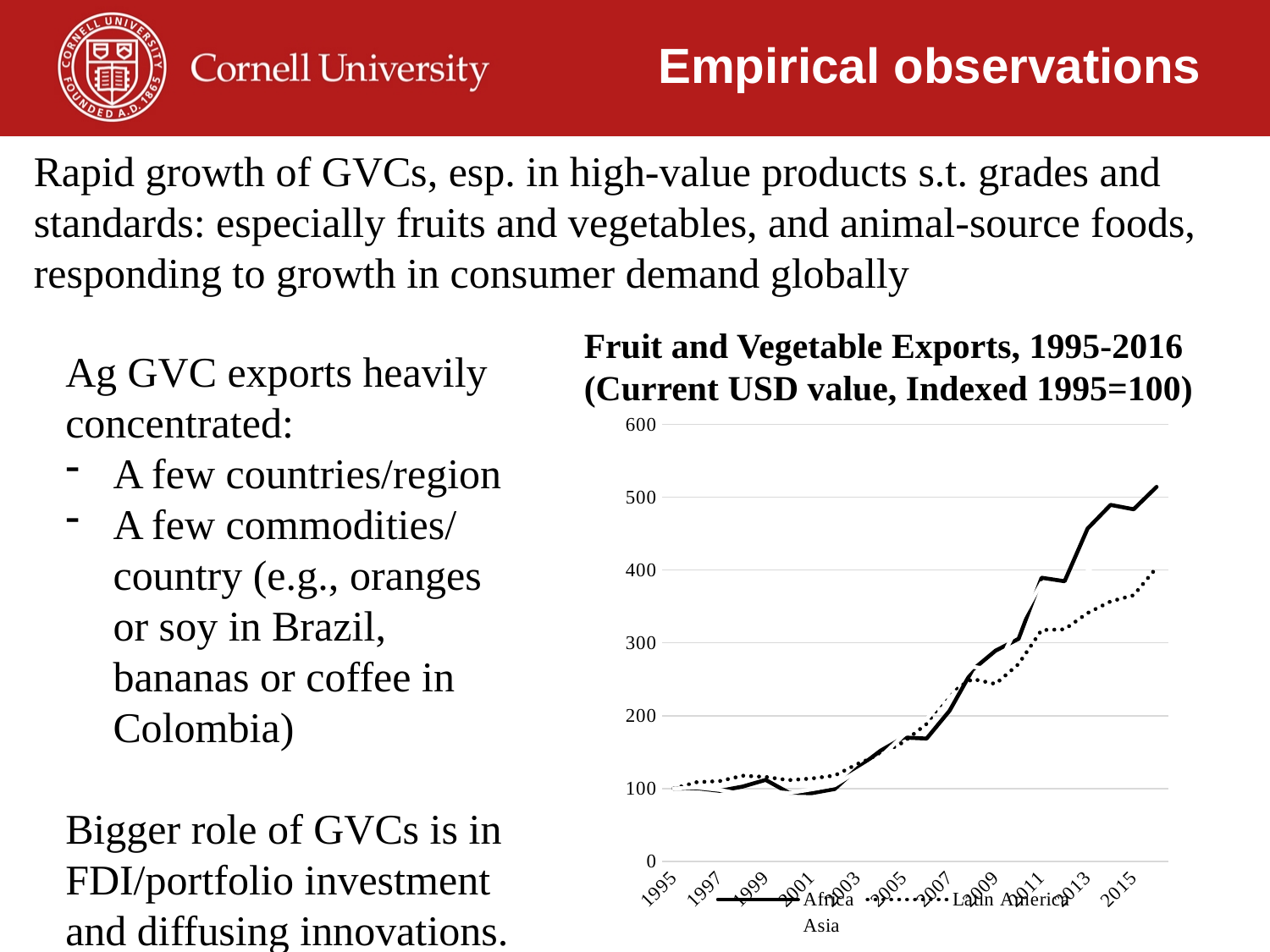
Do the values in the chart generally rise or fall from 1995 to 2016? rise What is the title of the chart? Fruit and Vegetable Exports, 1995-2016 (Current USD value, Indexed 1995=100) How many series does the chart's legend list? 3 Is the value of the dotted line (Latin America) in 2005 greater or less than 200? less What kind of chart is shown on the slide? line chart Is the final value of the thick solid line greater or less than 400? greater Which line ends higher in 2016, the thick solid line or the dotted line? the thick solid line What is the highest value shown on the chart's vertical axis? 600 Which regions are listed in the chart's legend? Africa, Latin America, Asia Is the final value of the dotted line (Latin America) greater or less than 500? less What is the first year shown on the chart's horizontal axis? 1995